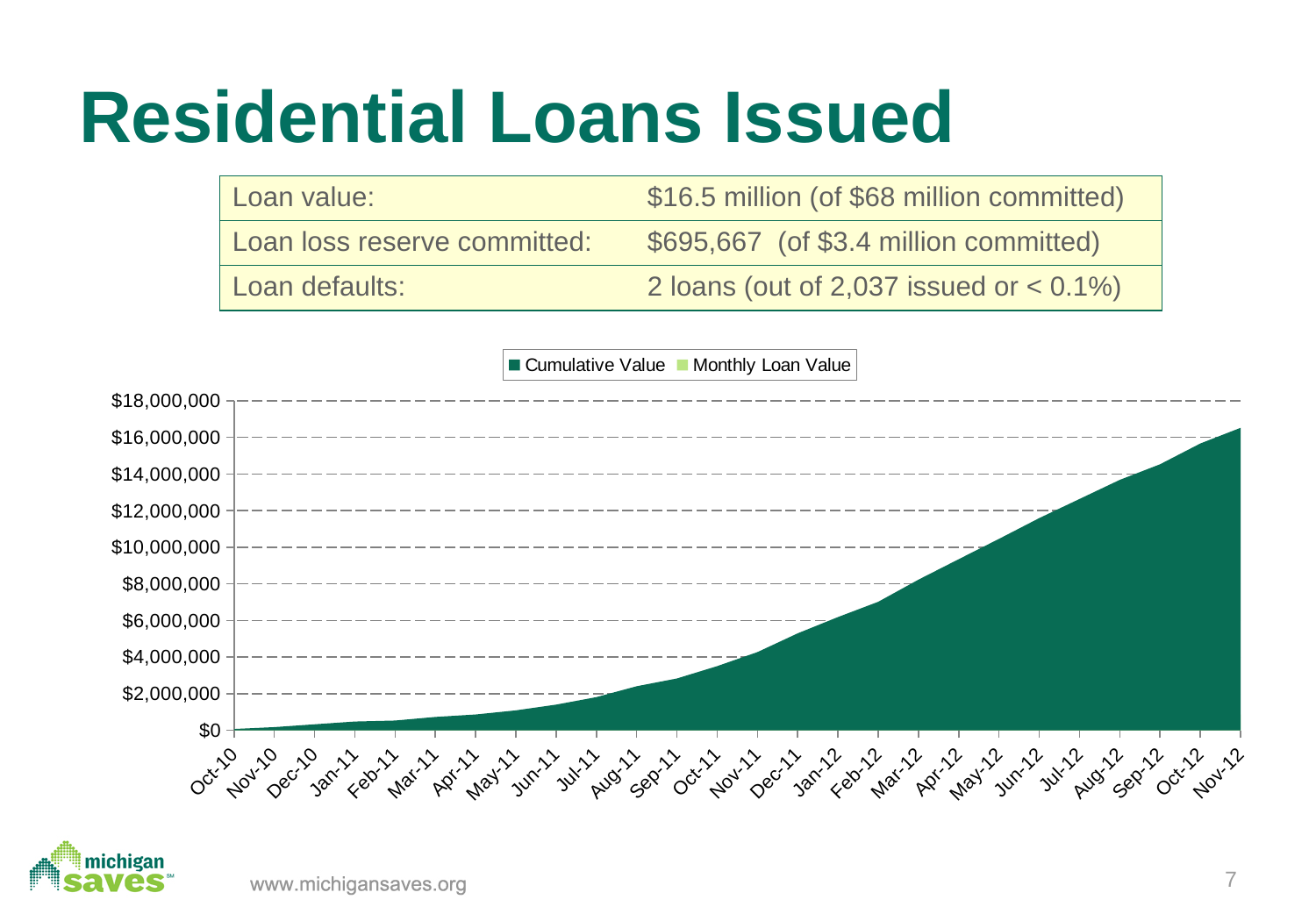
How many months are plotted along the x axis of the chart? 26 Is the Cumulative Value for Jun-11 greater or less than $2,000,000? less Which is larger, the Cumulative Value for Oct-11 or for Nov-12? Nov-12 Which month has the highest Cumulative Value? Nov-12 Does the Cumulative Value rise or fall from Oct-10 to Nov-12? Rises Which month has the lowest Cumulative Value? Oct-10 How many series does the chart legend list? 2 Is the Cumulative Value for Jul-12 greater or less than $12,000,000? greater What kind of chart is shown on the slide? Area chart Is the Cumulative Value for Jan-12 greater or less than $8,000,000? less What is the highest value labelled on the chart's y axis? $18,000,000